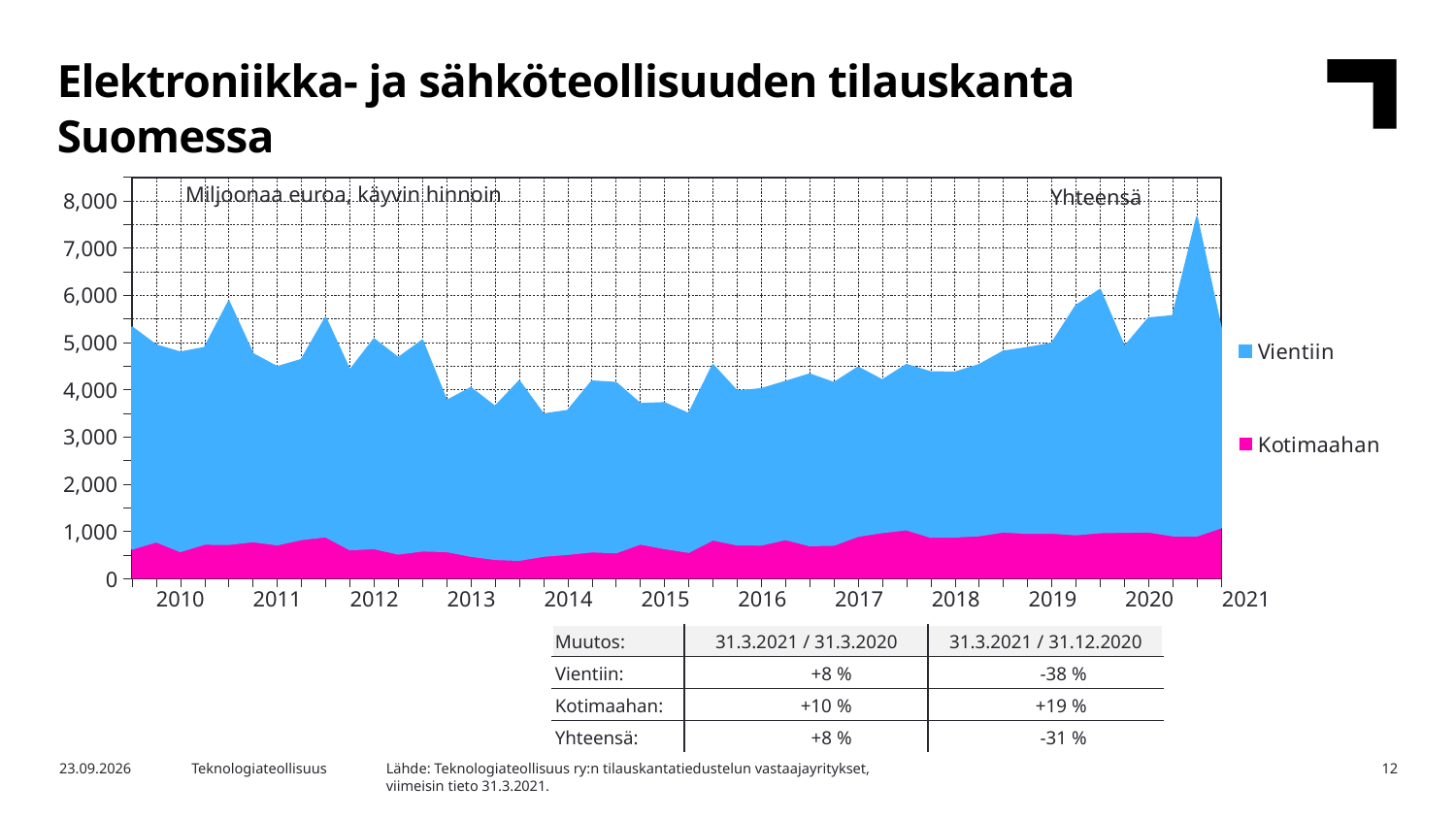
What are the two series named in the chart legend? Vientiin and Kotimaahan How many series does the chart legend list? 2 Is the Kotimaahan value in 2010 greater or less than 1,000? less What kind of chart is shown on the slide? Area chart What unit is stated in the label at the top of the chart? Miljoonaa euroa, käyvin hinnoin Is the Kotimaahan value in 2019 greater or less than 500? greater Is the total (Yhteensä) value in 2014 greater or less than 5,000? less How many year labels are shown on the x axis? 12 Which series is larger throughout the chart, Vientiin or Kotimaahan? Vientiin Does the total (Yhteensä) value generally rise or fall from 2018 to the peak in 2020? rise